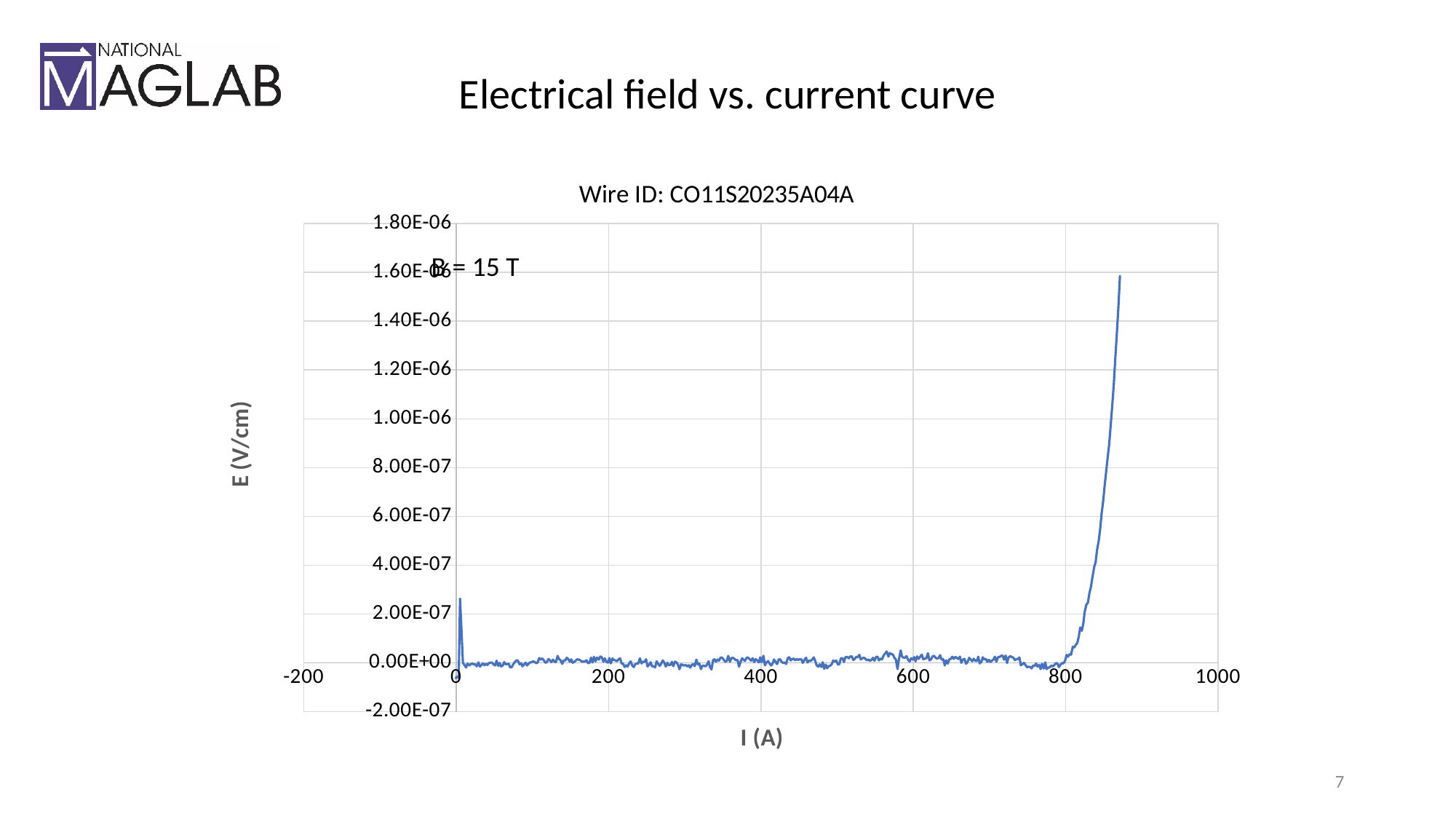
Is the value of E at I = 200 A greater or less than 4.00E-07? less Is the highest value of E reached by the curve greater or less than 1.40E-06? greater What is the highest tick value shown on the y axis? 1.80E-06 What kind of chart is shown on the slide? line chart Is the value of E at I = 850 A greater or less than 2.00E-07? greater What is the title of the chart? Wire ID: CO11S20235A04A What is the label of the y axis of the chart? E (V/cm) Does the curve reach its highest E value near the low end or the high end of the I axis? high end Does the curve rise or fall as I increases from 800 A to its end? rise